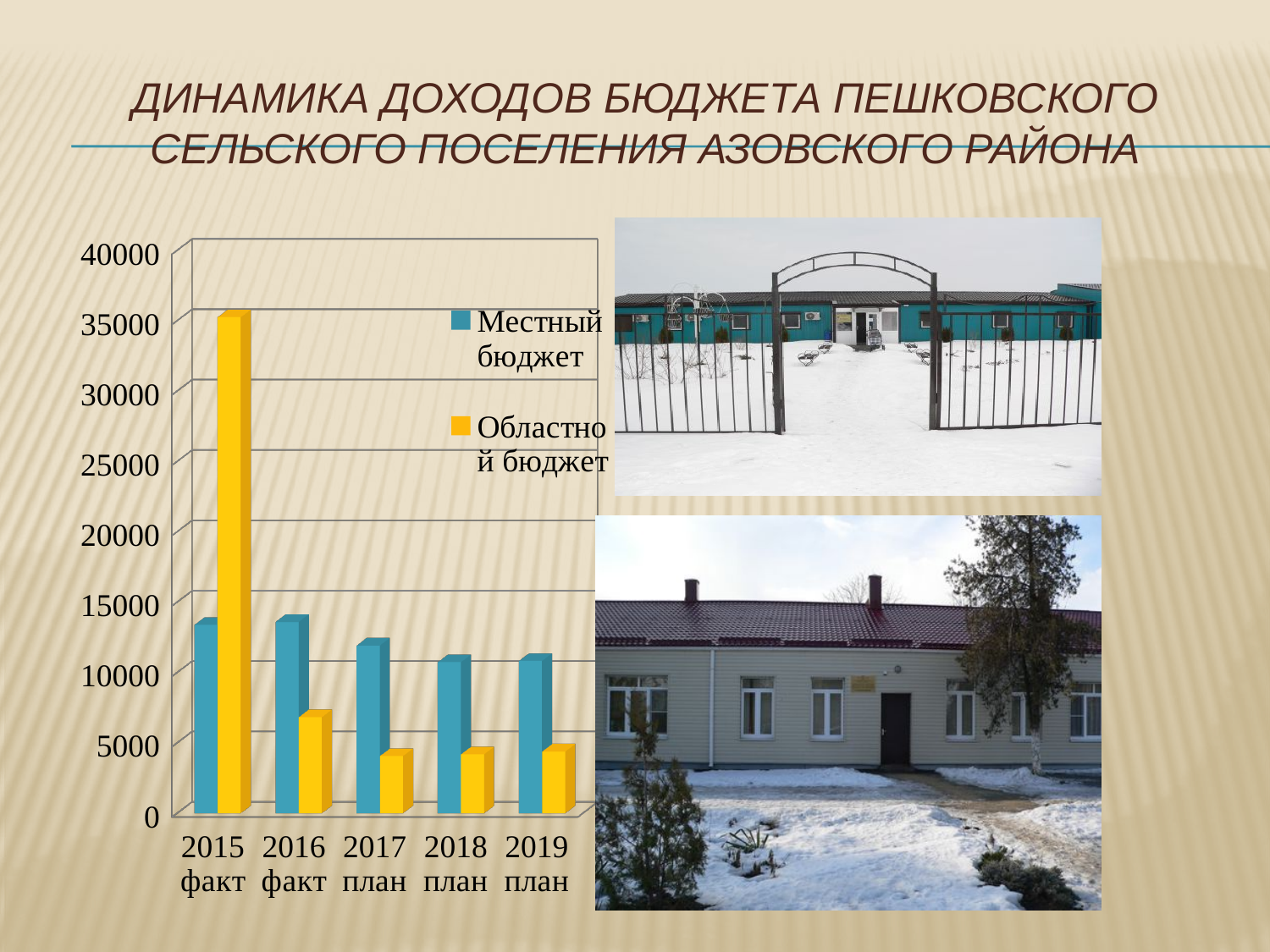
Is the Областной бюджет value for 2017 план greater or less than 10000? less What kind of chart is shown on the slide? bar chart Is the Областной бюджет value for 2016 факт greater or less than 10000? less How many series does the chart legend list? 2 Which is larger for 2016 факт: Местный бюджет or Областной бюджет? Местный бюджет Which colour represents Местный бюджет in the chart legend? blue How many categories are shown on the x axis of the chart? 5 Is the Областной бюджет value for 2015 факт greater or less than 30000? greater Which is larger for 2015 факт: Местный бюджет or Областной бюджет? Областной бюджет In which year is the Областной бюджет value highest? 2015 факт Does the Областной бюджет value rise or fall from 2015 факт to 2017 план? fall